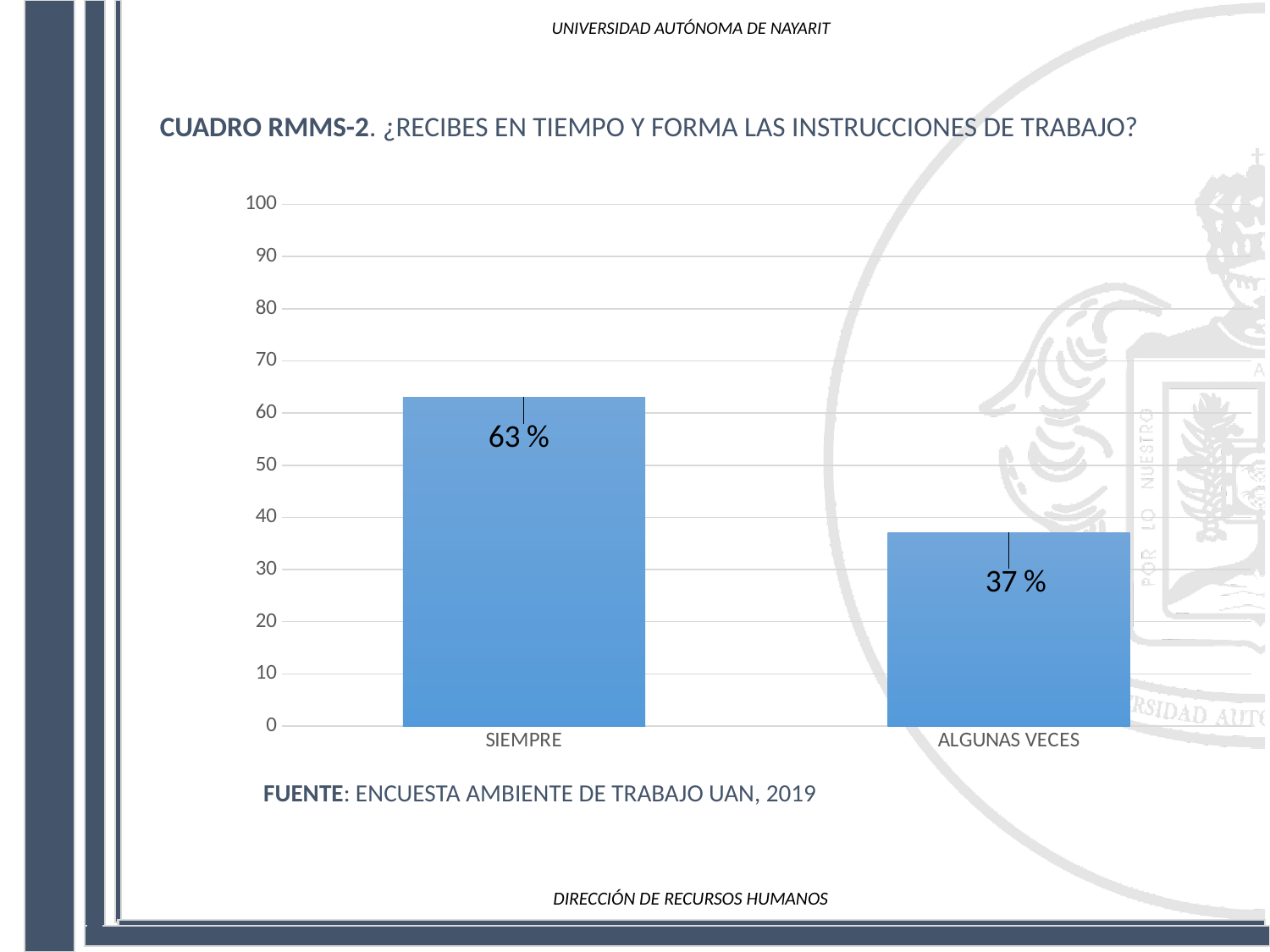
What is the difference between the values for SIEMPRE and ALGUNAS VECES? 26 % Is the value for SIEMPRE greater or less than 50? greater What kind of chart is shown on the slide? bar chart Which is larger, the value for SIEMPRE or the value for ALGUNAS VECES? SIEMPRE What is the value for SIEMPRE? 63 % Is the value for ALGUNAS VECES greater or less than 40? less What source is cited below the chart? ENCUESTA AMBIENTE DE TRABAJO UAN, 2019 What is the value for ALGUNAS VECES? 37 % Which category has the lowest value? ALGUNAS VECES What is the maximum value shown on the vertical axis? 100 Which category has the highest value? SIEMPRE How many categories are shown on the chart? 2